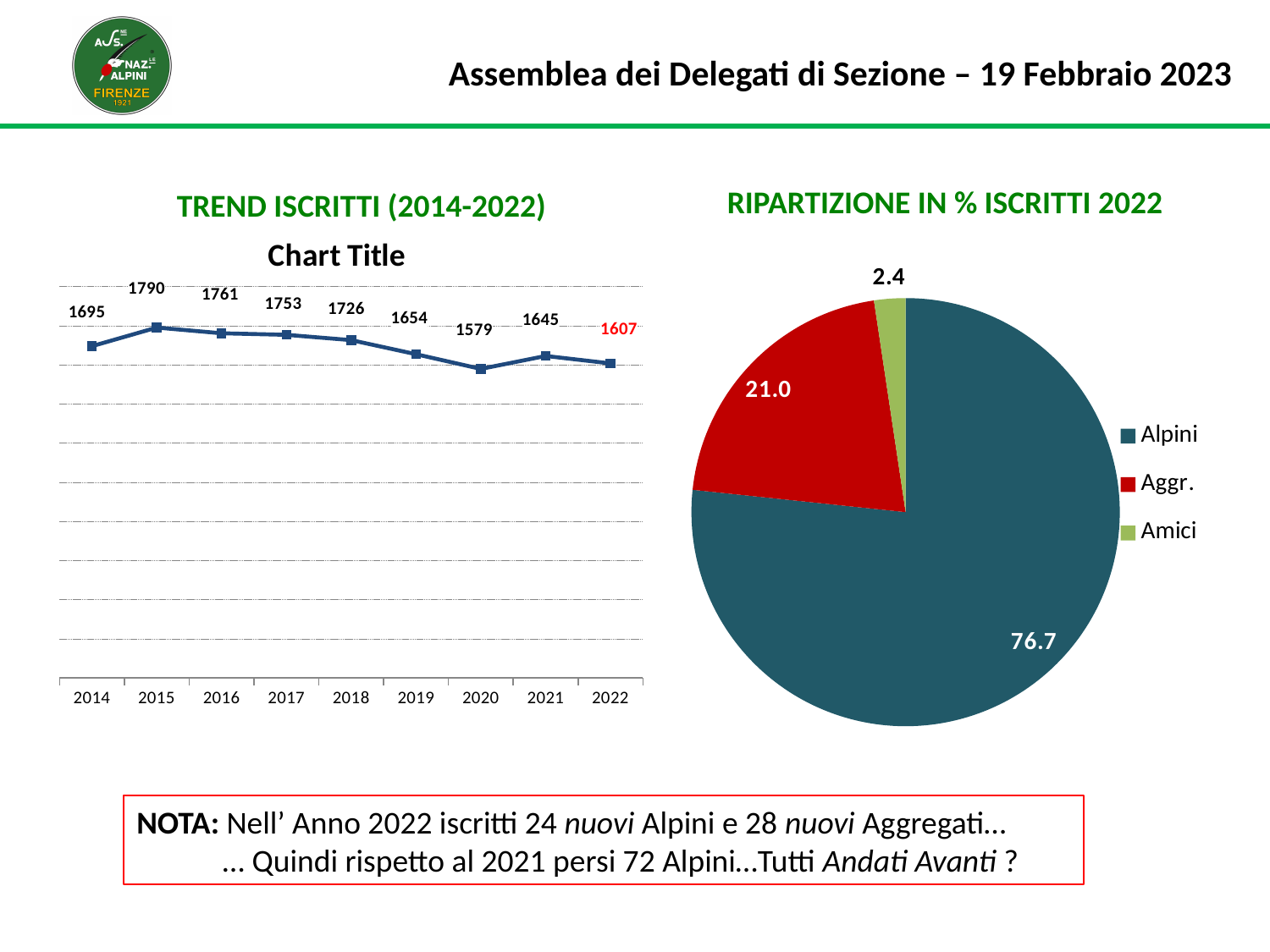
In the TREND ISCRITTI (2014-2022) chart, which year has the highest value? 2015 In the RIPARTIZIONE IN % ISCRITTI 2022 pie chart, which category has the smallest slice? Amici In the TREND ISCRITTI (2014-2022) chart, how many years are plotted? 9 In the TREND ISCRITTI (2014-2022) chart, what is the difference between the 2021 and 2022 values? 38 In the TREND ISCRITTI (2014-2022) chart, which year has the lowest value? 2020 In the RIPARTIZIONE IN % ISCRITTI 2022 pie chart, what is the value for Aggr.? 21.0 In the RIPARTIZIONE IN % ISCRITTI 2022 pie chart, what colour is the Alpini slice? dark teal How many categories does the legend of the RIPARTIZIONE IN % ISCRITTI 2022 pie chart list? 3 In the TREND ISCRITTI (2014-2022) chart, what is the value for 2015? 1790 What type of chart is the TREND ISCRITTI (2014-2022) chart? line chart In the TREND ISCRITTI (2014-2022) chart, what is the value for 2022? 1607 In the TREND ISCRITTI (2014-2022) chart, do the values generally rise or fall from 2015 to 2020? fall